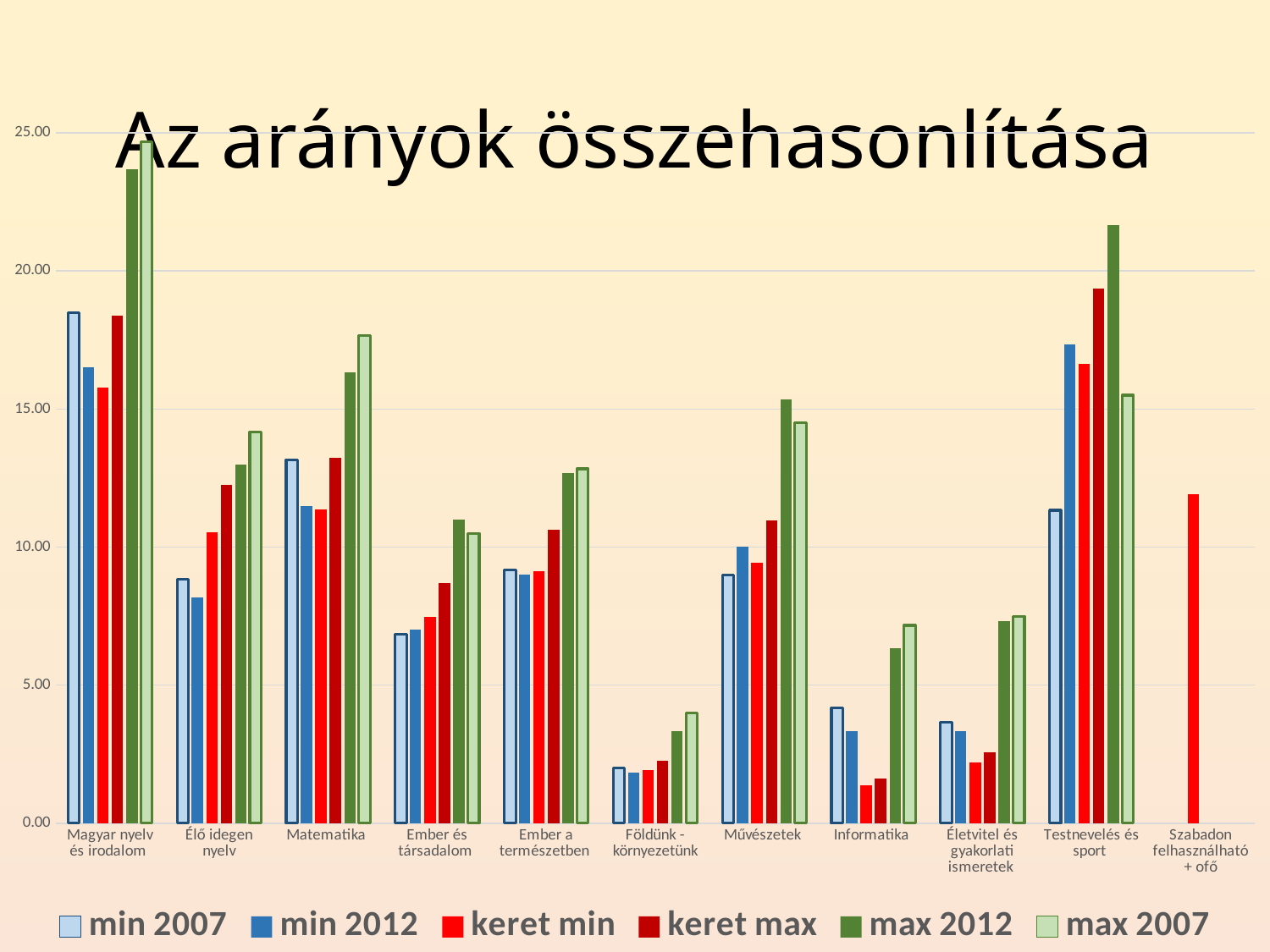
Which is larger: the max 2007 value for Földünk - környezetünk or the max 2007 value for Művészetek? Művészetek How many categories are shown along the x axis? 11 Which category has the highest max 2007 value? Magyar nyelv és irodalom Which category has the shortest min 2007 bar? Földünk - környezetünk Is the max 2007 value for Matematika greater or less than 15.00? greater What kind of chart is shown on the slide? bar chart For Magyar nyelv és irodalom, which is larger: min 2007 or min 2012? min 2007 Is the max 2012 value for Informatika greater or less than 5.00? greater Is the keret min value for Szabadon felhasználható + ofő greater or less than 10.00? greater How many series does the legend list? 6